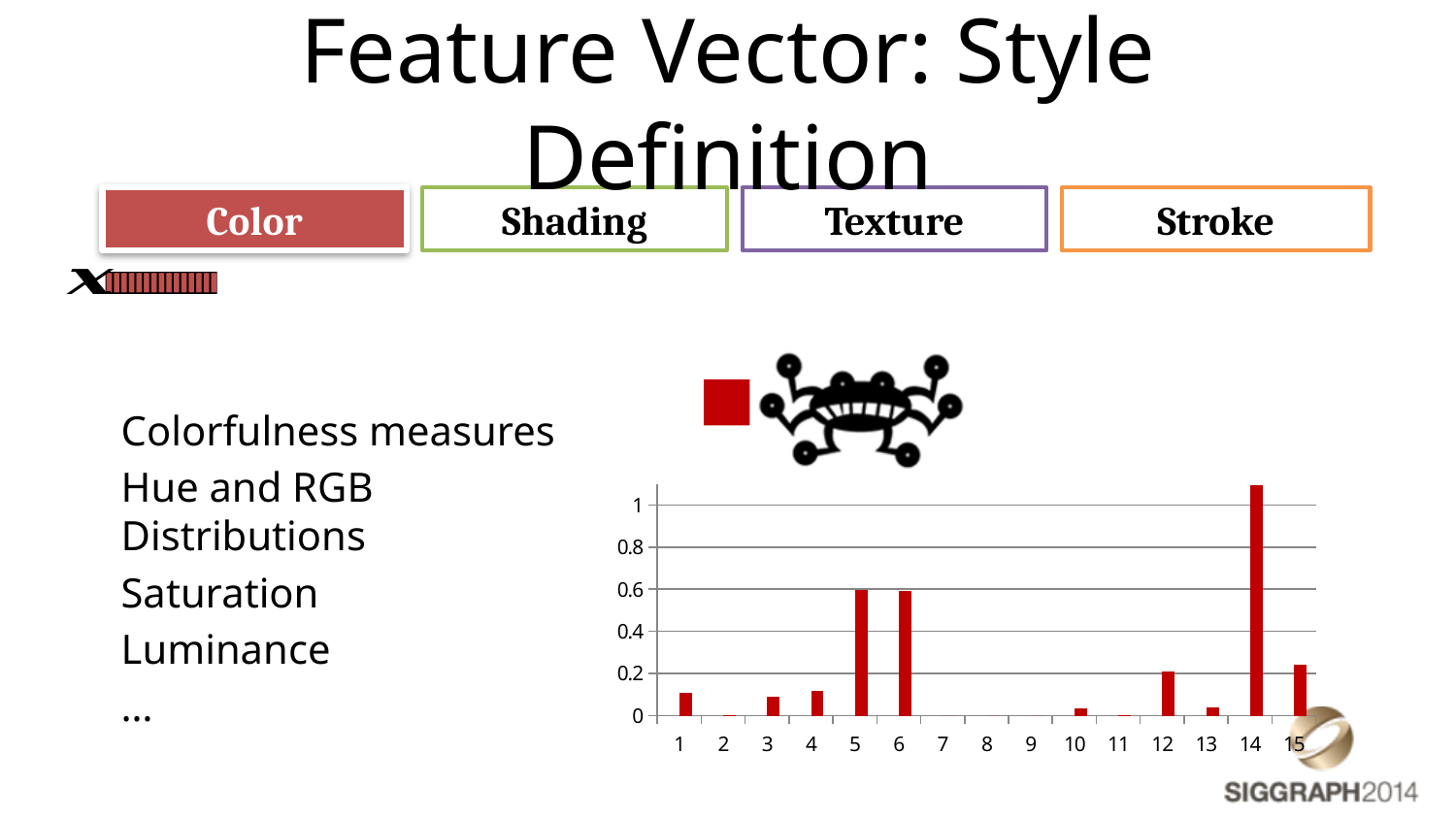
Is the value for category 6 greater or less than 0.4? greater Which is larger, the value for category 12 or the value for category 13? 12 What kind of chart is shown on the slide? bar chart Which is larger, the value for category 14 or the value for category 5? 14 Is the value for category 5 greater or less than 0.4? greater Is the value for category 10 greater or less than 0.2? less Which category has the highest bar in the chart? 14 Which is larger, the value for category 1 or the value for category 5? 5 How many categories are shown on the x axis of the chart? 15